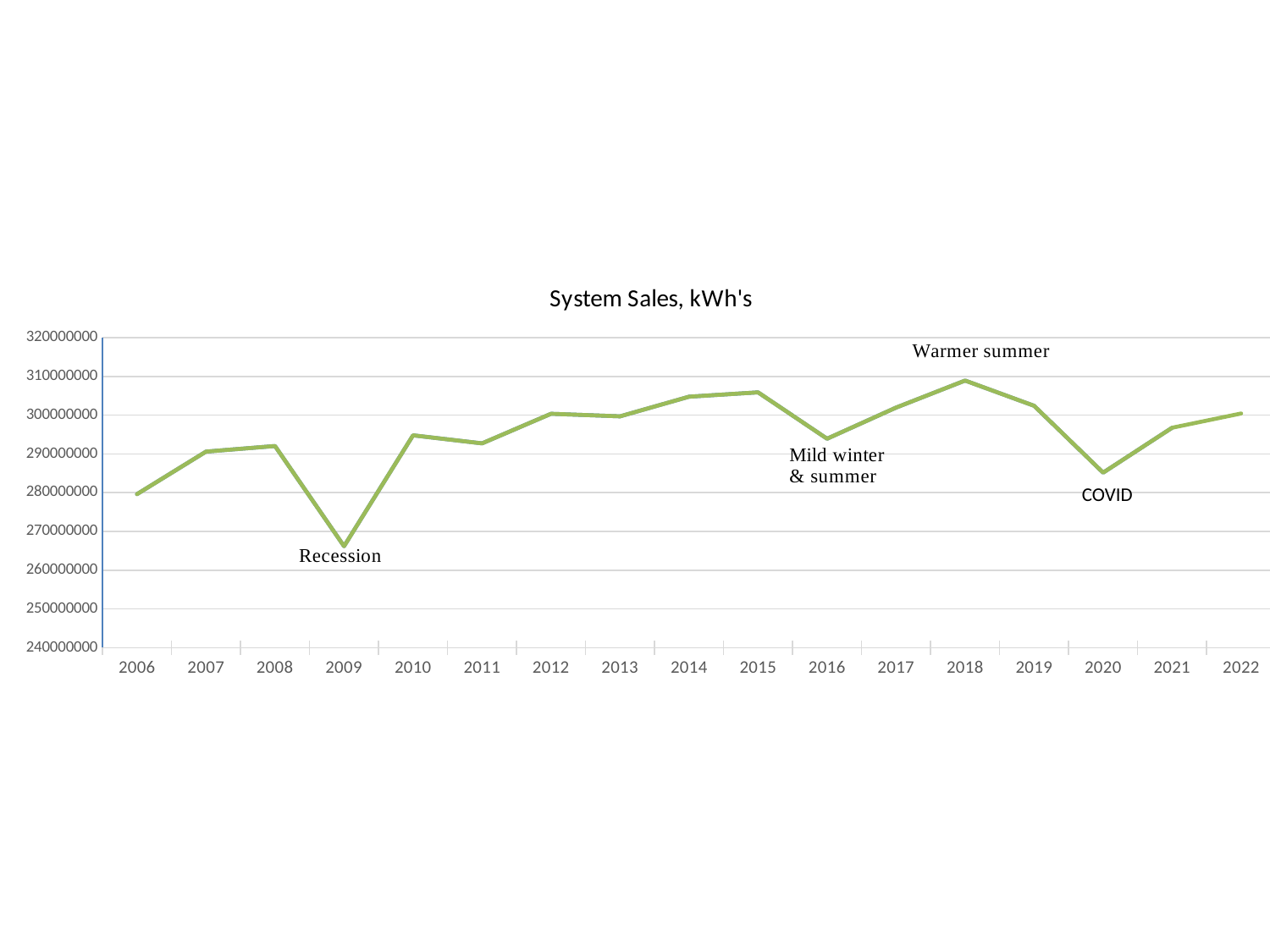
Do system sales rise or fall from 2018 to 2020? fall Which year has the lowest system sales? 2009 Is the value for 2016 greater or less than 300000000? less Which year has higher system sales, 2015 or 2016? 2015 Which year has the highest system sales? 2018 How many years are plotted on the x axis? 17 What is the title of the chart? System Sales, kWh's Is the value for 2009 greater or less than 270000000? less Is the value for 2018 greater or less than 300000000? greater What annotation is placed next to the 2009 low point on the chart? Recession What kind of chart is shown on the slide? line chart